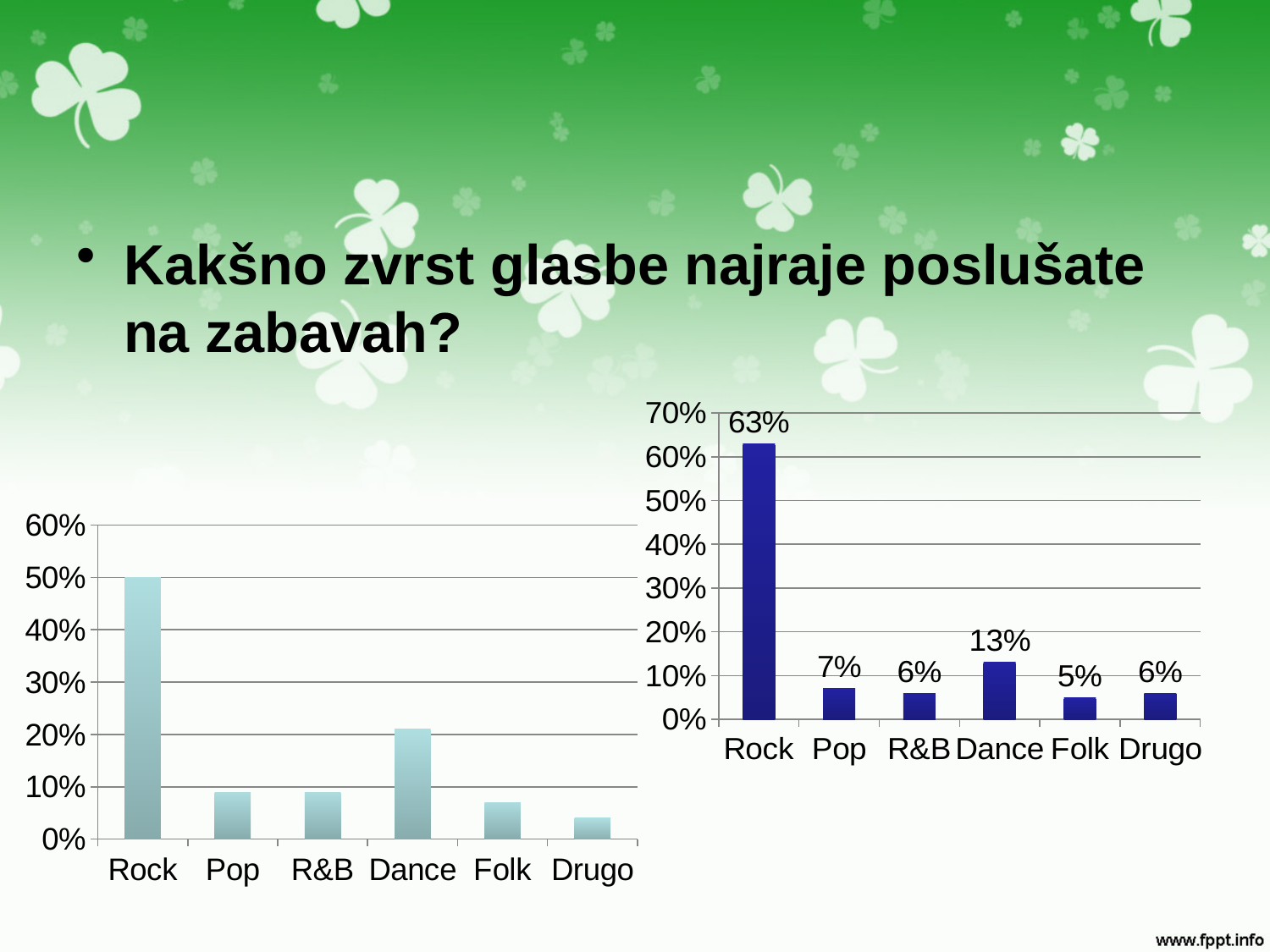
In the right-hand chart, what is the difference between the values for Rock and Dance? 50% What kind of chart is the right-hand chart? Bar chart In the left-hand chart, which category has the highest value? Rock In the left-hand chart, is the value for Drugo greater or less than 10%? less In the right-hand chart, what is the value for Rock? 63% In the right-hand chart, what is the value for Dance? 13% How many categories are shown in the left-hand chart? 6 In the right-hand chart, which is larger, the value for Pop or the value for Dance? Dance In the left-hand chart, is the value for Dance greater or less than 10%? greater In the right-hand chart, what is the value for Folk? 5% In the right-hand chart, which category has the lowest value? Folk In the right-hand chart, which category has the highest value? Rock